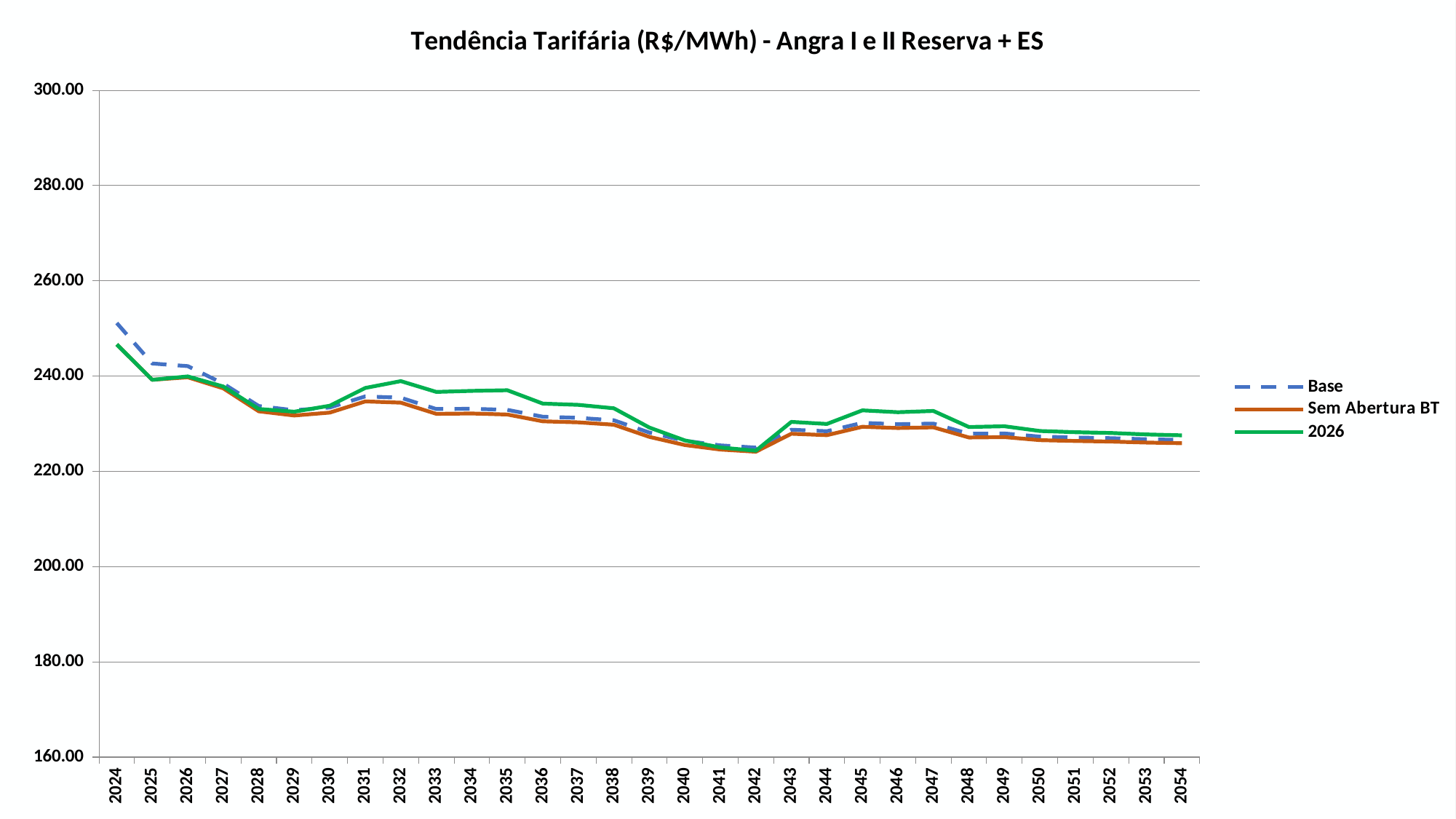
Is the value for Base in 2024 greater or less than 240? greater What kind of chart is shown on the slide? line chart Is the value for the 2026 series in 2042 greater or less than 240? less How many series does the legend list? 3 How many years are shown along the x axis? 31 Is the value for Base in 2024 greater or less than 260? less What is the title of the chart? Tendência Tarifária (R$/MWh) - Angra I e II Reserva + ES Which series is drawn as a dashed line? Base Which series has the higher value in 2032, Base or 2026? 2026 In which year is the Base series at its highest value? 2024 Which is larger for the Base series, the value in 2024 or the value in 2054? 2024 Overall, do the values of the Base series rise or fall from 2024 to 2054? fall